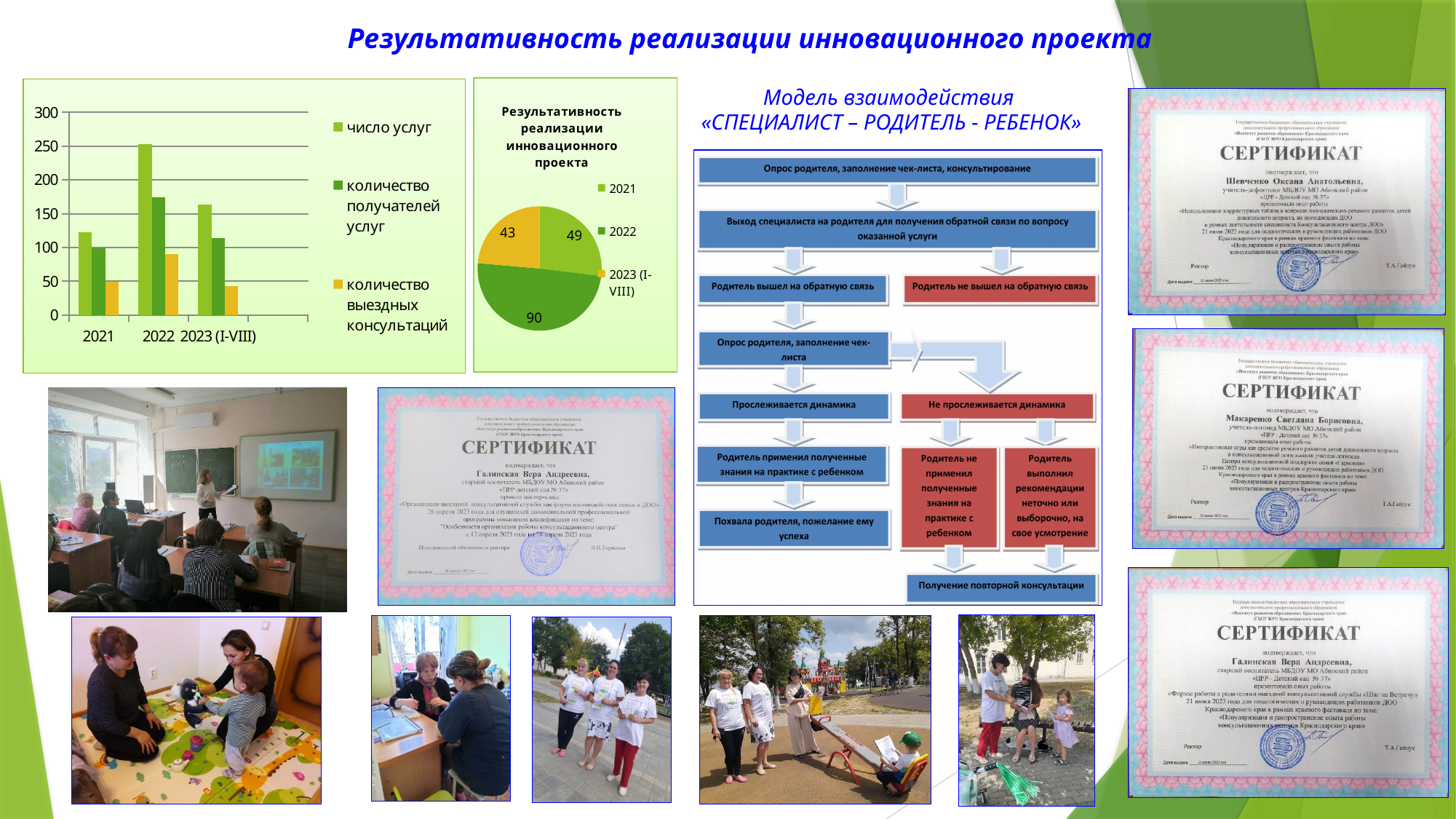
In the pie chart titled «Результативность реализации инновационного проекта», how many slices are there? 3 In the bar chart on the left of the slide, how many series does the legend list? 3 In the pie chart titled «Результативность реализации инновационного проекта», which year has the largest slice? 2022 In the pie chart titled «Результативность реализации инновационного проекта», what is the difference between the values for 2022 and 2021? 41 In the pie chart titled «Результативность реализации инновационного проекта», what is the value for 2021? 49 In the bar chart on the left of the slide, in which year is the value for «число услуг» highest? 2022 In the bar chart on the left of the slide, is the value for «число услуг» in 2022 greater or less than 200? greater In the pie chart titled «Результативность реализации инновационного проекта», what is the value for 2022? 90 In the pie chart titled «Результативность реализации инновационного проекта», what is the value for 2023 (I-VIII)? 43 What type of chart is the chart on the far left of the slide? bar chart In the bar chart on the left of the slide, which is larger in 2021: «число услуг» or «количество выездных консультаций»? число услуг